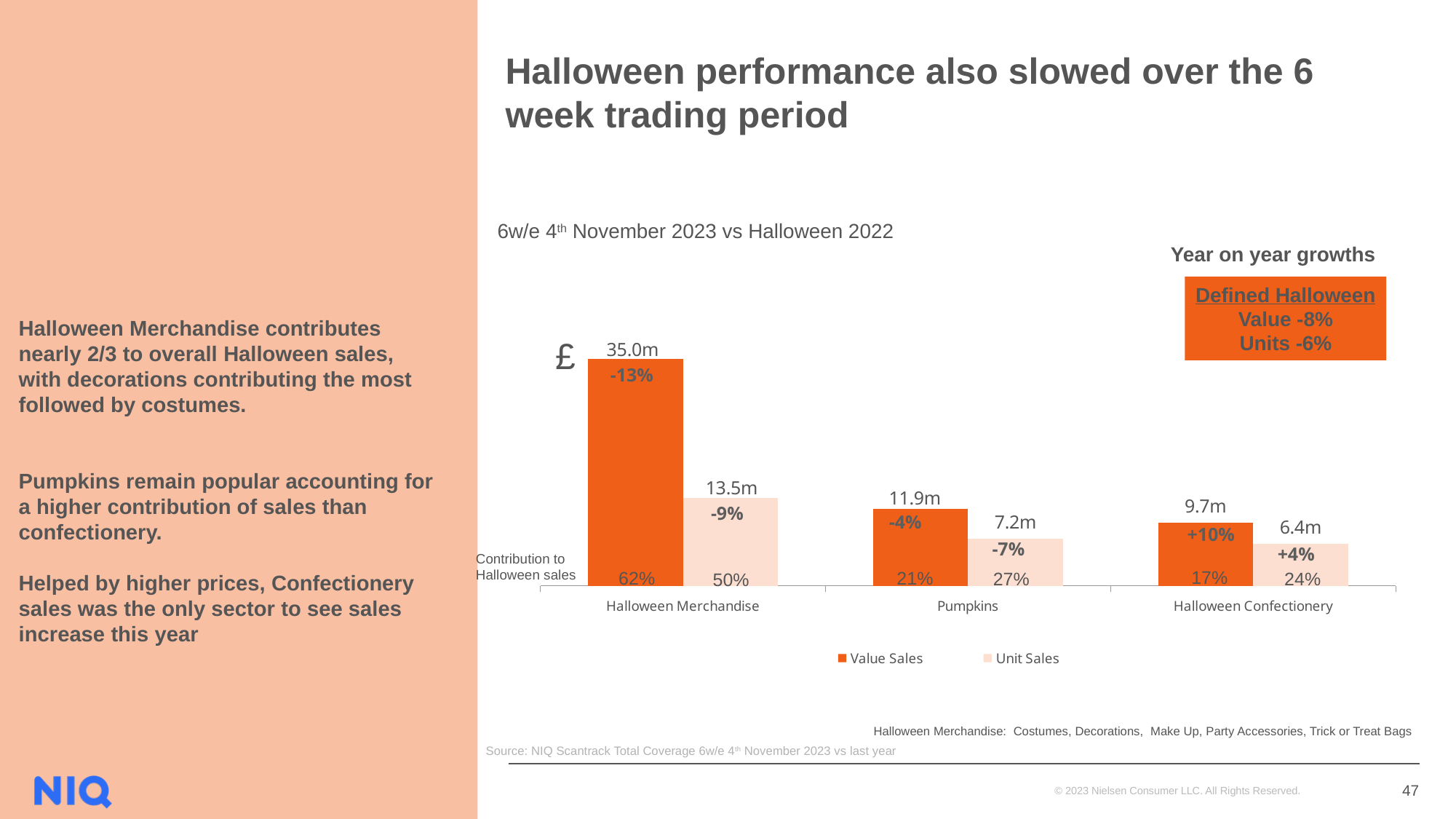
How many series does the chart legend list? 2 Which is larger: Unit Sales for Halloween Merchandise or Value Sales for Pumpkins? Unit Sales for Halloween Merchandise Which category has the lowest Unit Sales? Halloween Confectionery What year-on-year growth is shown on the Value Sales bar for Halloween Merchandise? -13% Which category has the highest Value Sales? Halloween Merchandise How many categories are shown on the x axis of the chart? 3 What is the Value Sales figure for Halloween Confectionery? 9.7m What is the Unit Sales figure for Pumpkins? 7.2m What type of chart is shown on the slide? Bar chart What year-on-year growth is shown on the Unit Sales bar for Halloween Confectionery? +4% What is the Value Sales figure for Halloween Merchandise? 35.0m What is the difference between Value Sales for Pumpkins and Value Sales for Halloween Confectionery? 2.2m